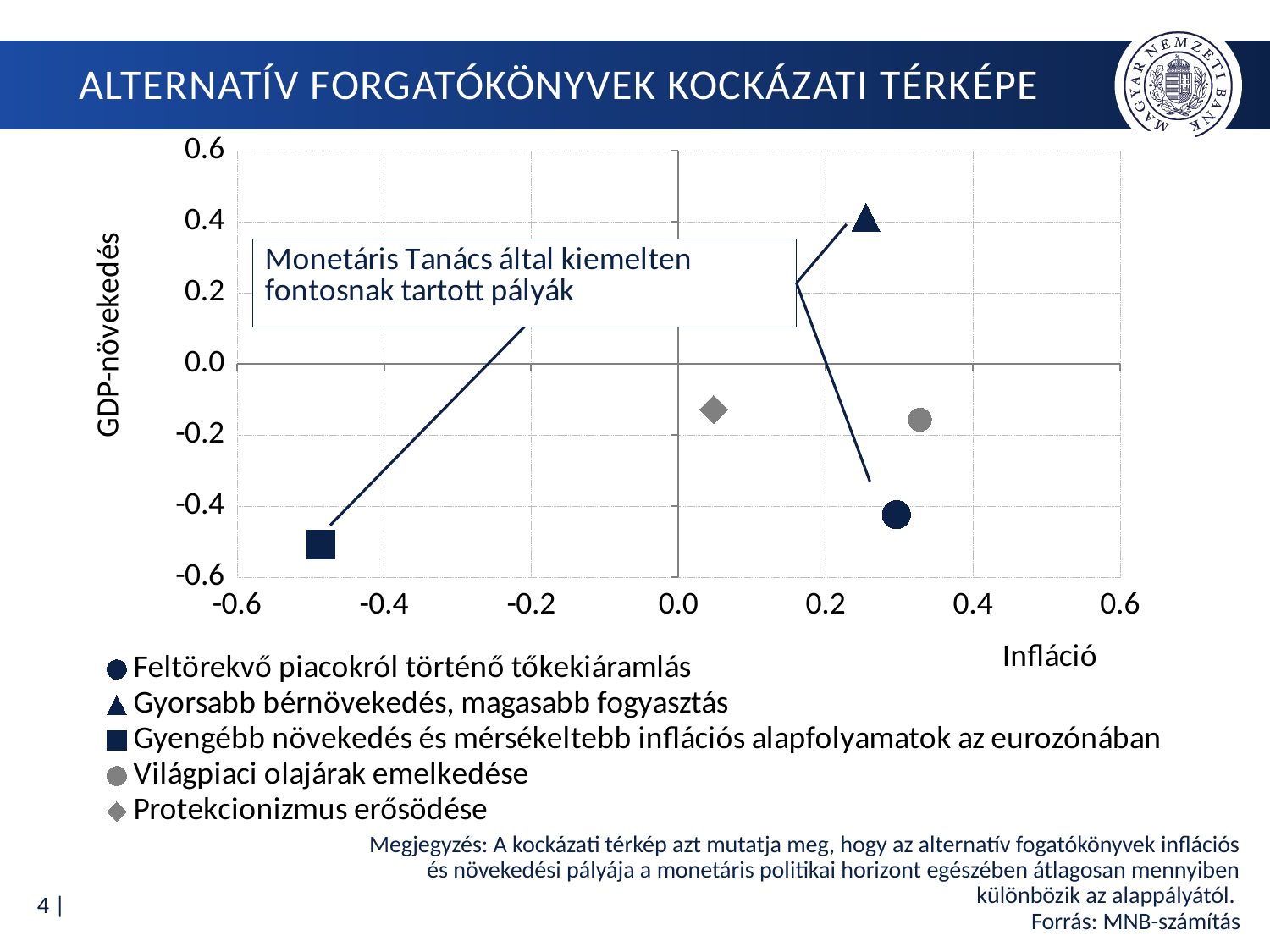
Is the Infláció value for Gyengébb növekedés és mérsékeltebb inflációs alapfolyamatok az eurozónában greater or less than -0.4? less What kind of chart is shown on the slide? scatter chart What is the label of the vertical axis of the chart? GDP-növekedés Which scenario has the lowest Infláció value? Gyengébb növekedés és mérsékeltebb inflációs alapfolyamatok az eurozónában Which scenario has the lowest GDP-növekedés value? Gyengébb növekedés és mérsékeltebb inflációs alapfolyamatok az eurozónában Which has a lower Infláció value: Protekcionizmus erősödése or Világpiaci olajárak emelkedése? Protekcionizmus erősödése Is the GDP-növekedés value for Feltörekvő piacokról történő tőkekiáramlás greater or less than -0.2? less Which has a higher GDP-növekedés value: Világpiaci olajárak emelkedése or Feltörekvő piacokról történő tőkekiáramlás? Világpiaci olajárak emelkedése How many data points are plotted on the chart? 5 Is the GDP-növekedés value for Gyorsabb bérnövekedés, magasabb fogyasztás greater or less than 0.2? greater Which scenario has the highest GDP-növekedés value? Gyorsabb bérnövekedés, magasabb fogyasztás How many series does the legend list? 5